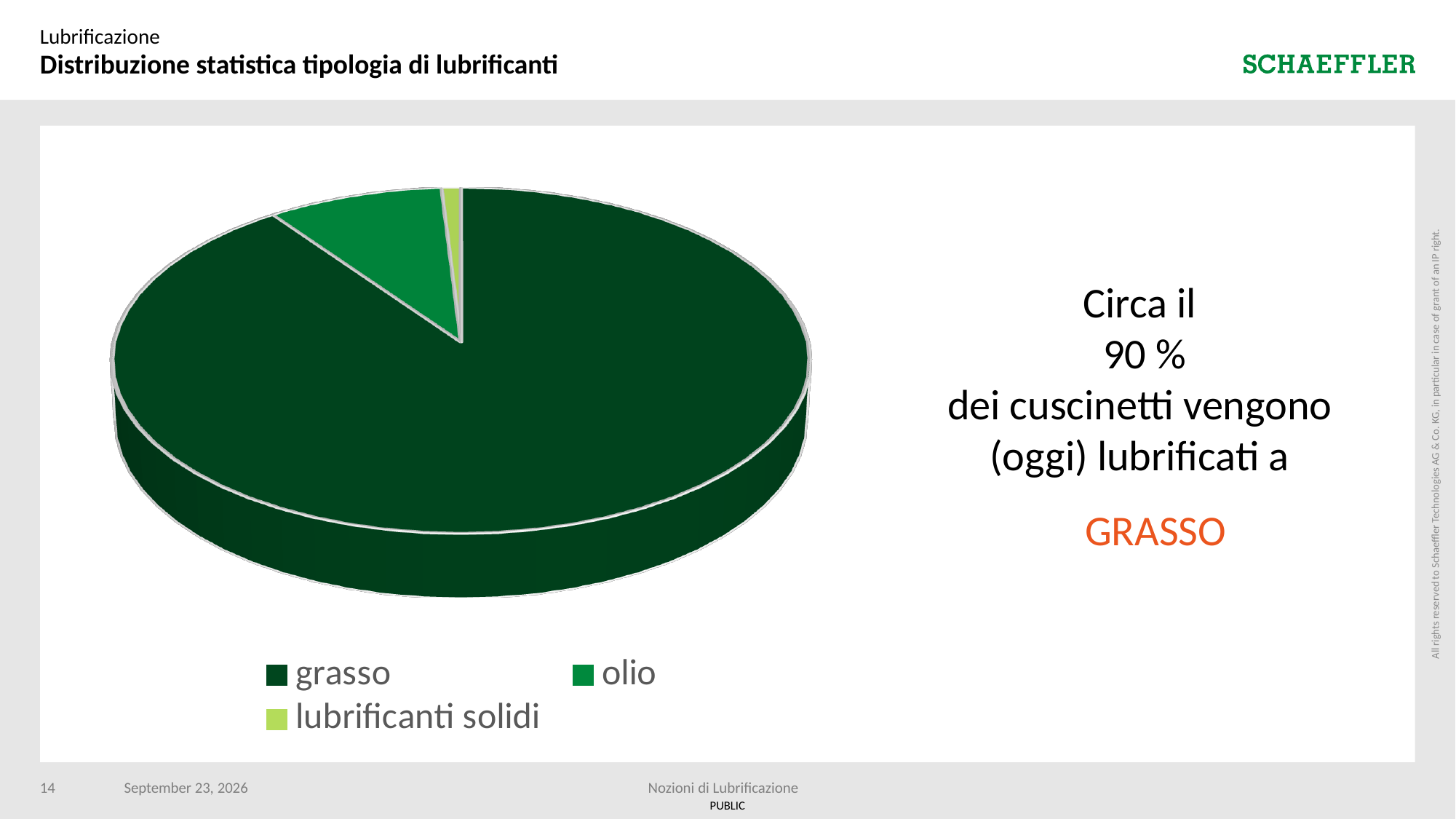
Is the share of grasso in the pie chart greater or less than 50%? greater Which category has the smallest slice of the pie chart? lubrificanti solidi Is the share of olio in the pie chart greater or less than 25%? less How many slices does the pie chart have? 3 Which slice is larger in the pie chart, olio or lubrificanti solidi? olio Which category has the largest slice of the pie chart? grasso What kind of chart is shown on the slide? Pie chart What are the three legend entries of the pie chart? grasso, olio, lubrificanti solidi Which slice is larger in the pie chart, grasso or olio? grasso How many entries does the legend of the pie chart list? 3 Which legend entry is shown in the lightest green colour? lubrificanti solidi